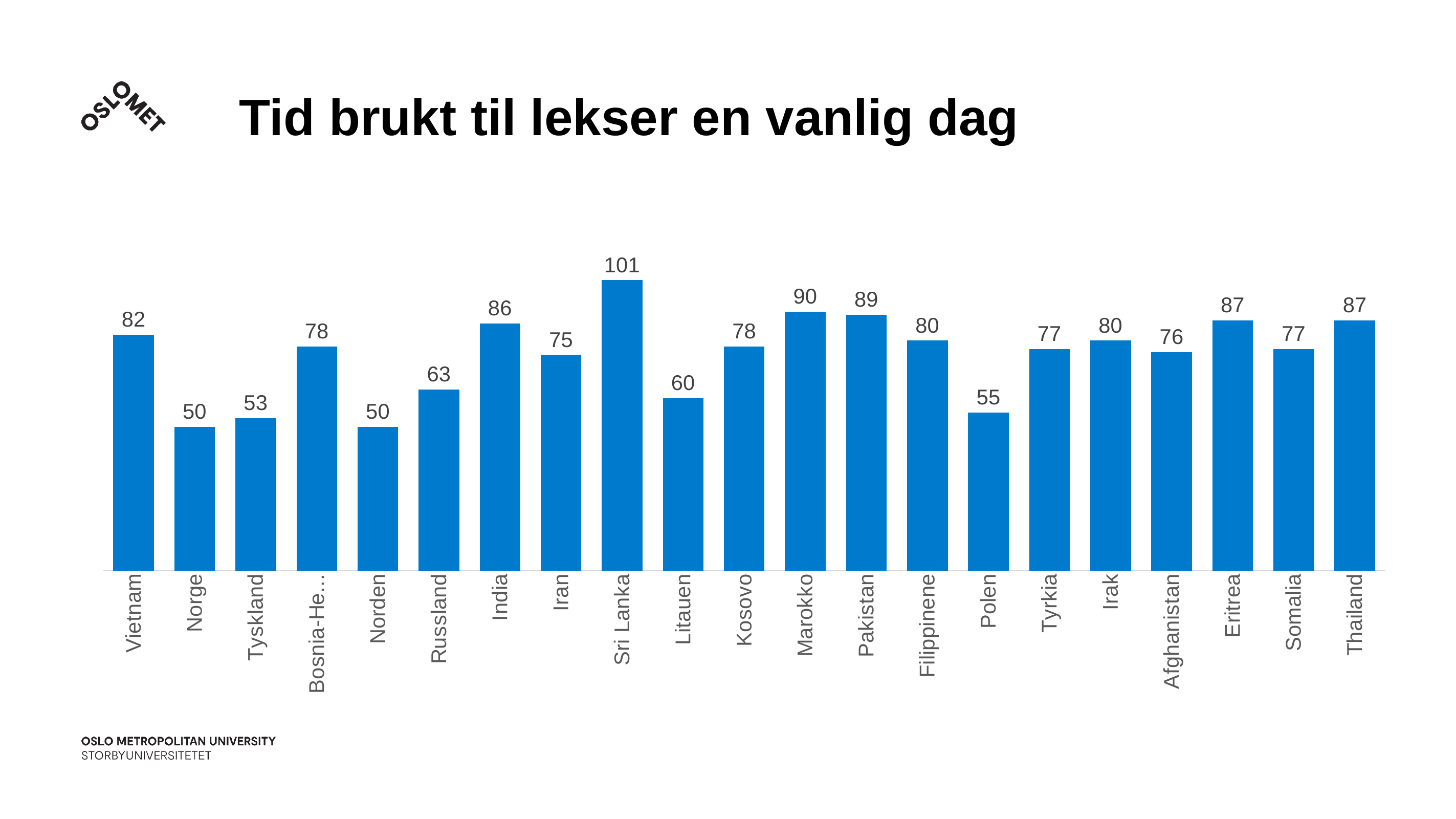
What kind of chart is shown on the slide? Bar chart What is the title of the slide? Tid brukt til lekser en vanlig dag Which is larger, the value for Pakistan or the value for Russland? Pakistan What is the value for Norge? 50 What is the value for Marokko? 90 Which category has the highest value? Sri Lanka What is the value for Polen? 55 What is the value for Sri Lanka? 101 How many categories are shown on the x axis? 21 What is the difference between the values for Vietnam and Tyskland? 29 What is the difference between the values for Sri Lanka and Litauen? 41 Which is larger, the value for India or the value for Iran? India